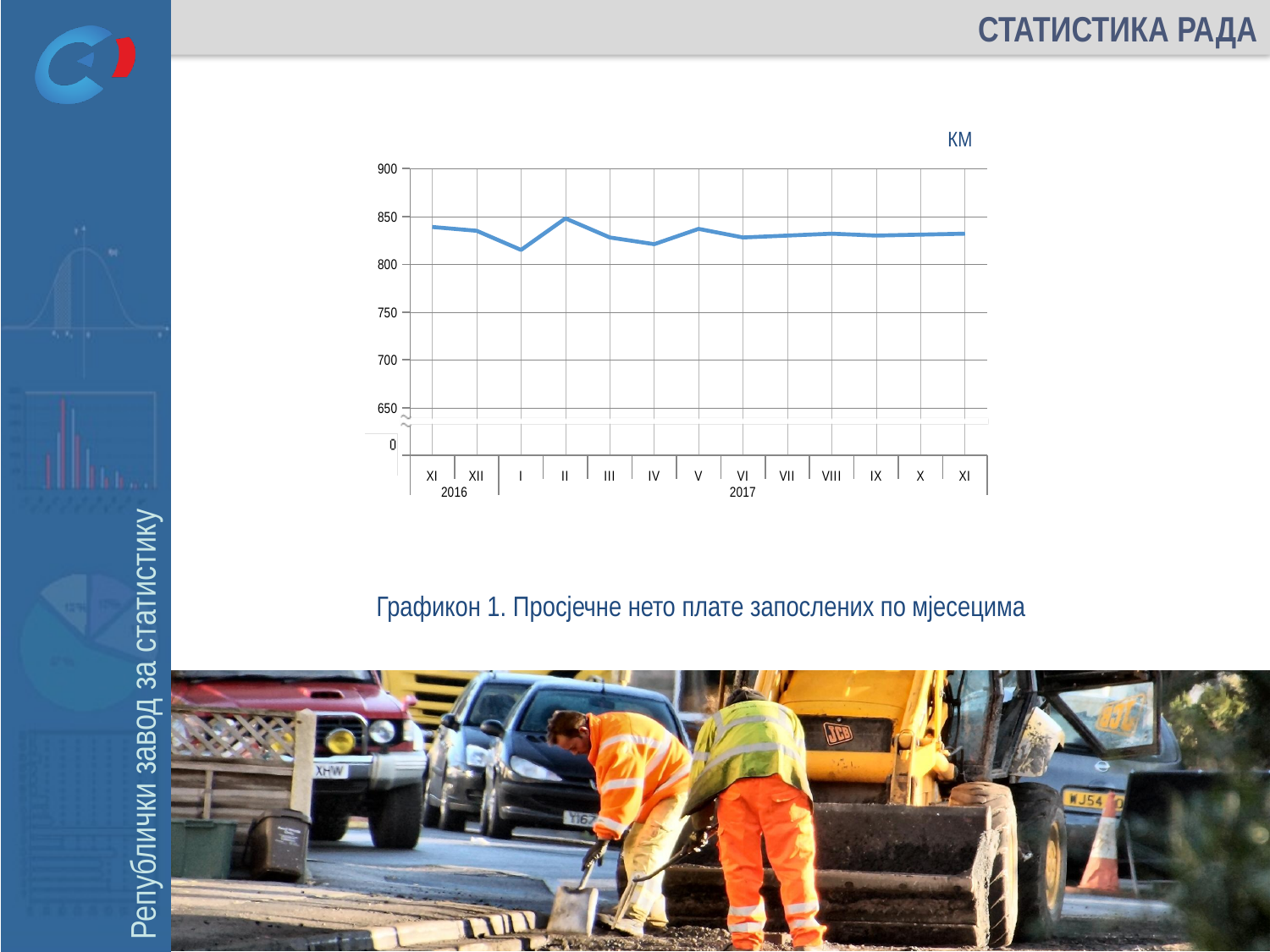
Does the line rise or fall from I 2017 to II 2017? rise In which month is the average net wage highest on the chart? II 2017 What kind of chart is shown on the slide? line chart Which is larger, the value for I 2017 or the value for II 2017? II 2017 What is the caption of the chart on the slide? Графикон 1. Просјечне нето плате запослених по мјесецима Is the value for XI 2016 greater or less than 800? greater What unit is indicated above the chart? KM Is the value for II 2017 greater or less than 800? greater Which is larger, the value for XI 2016 or the value for I 2017? XI 2016 How many monthly data points are plotted on the chart? 13 Is the value for I 2017 greater or less than 850? less In which month is the average net wage lowest on the chart? I 2017